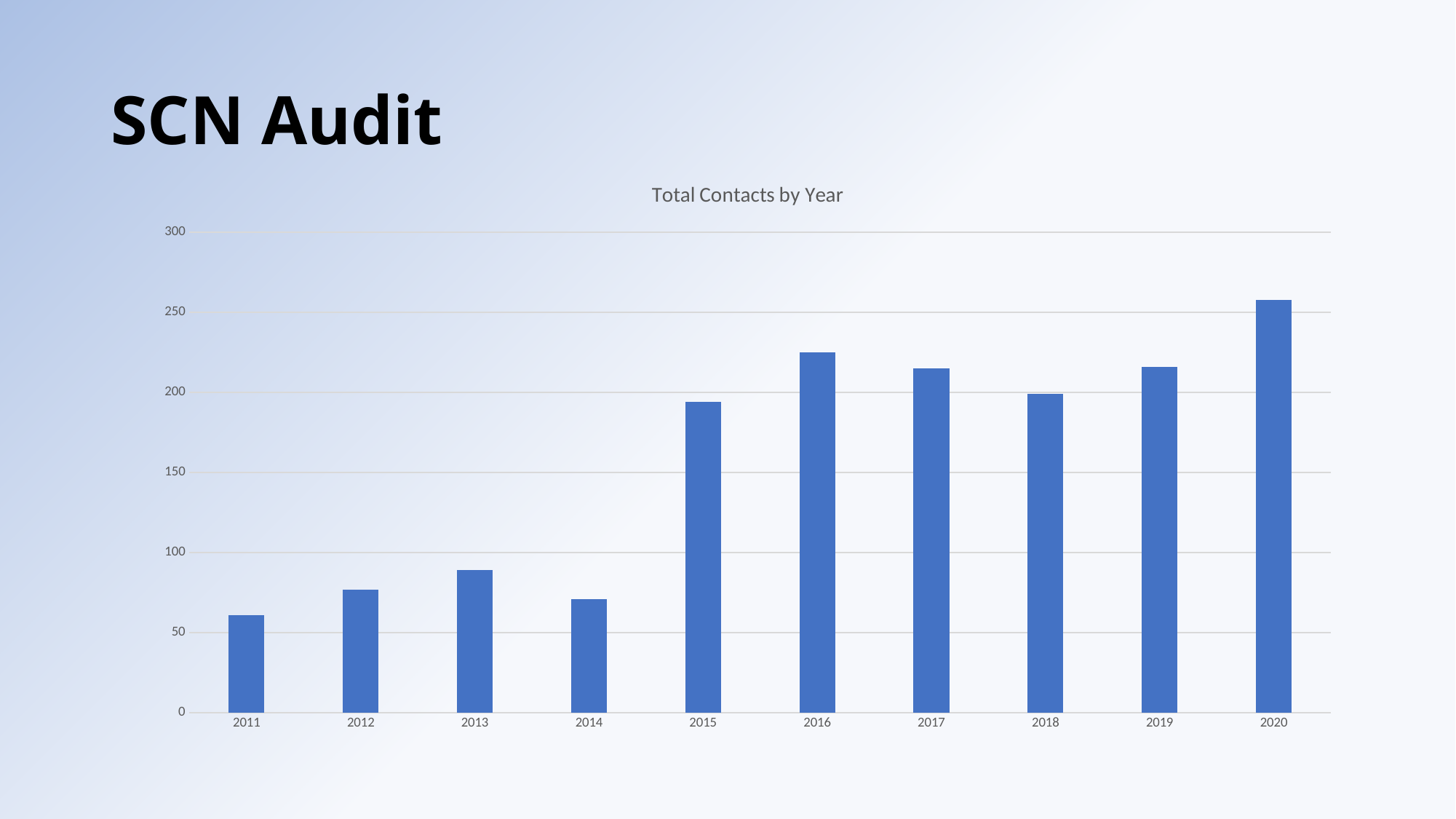
Which year has more total contacts, 2013 or 2014? 2013 Is the value for 2020 greater or less than 250? greater What is the title of the chart? Total Contacts by Year Is the value for 2015 greater or less than 200? less Which year has the highest total contacts? 2020 How many years are shown on the x axis of the chart? 10 Overall, do total contacts rise or fall from 2011 to 2020? rise Is the value for 2016 greater or less than 200? greater Which year has the lowest total contacts? 2011 What kind of chart is shown on the slide? bar chart Which year has more total contacts, 2015 or 2016? 2016